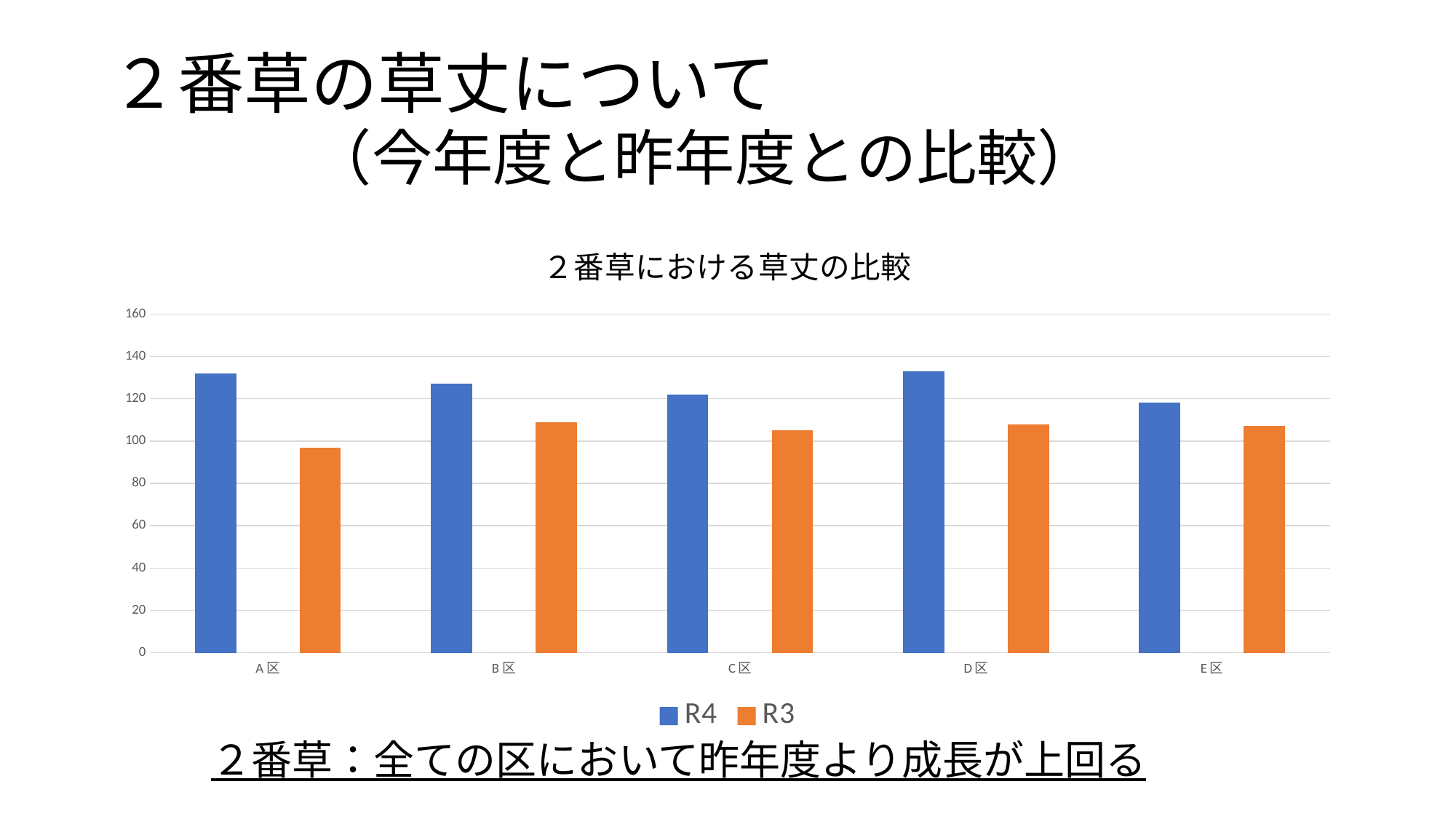
Which is larger, the R4 value for A区 or the R4 value for E区? A区 How many categories (districts) are shown on the x axis? 5 How many series does the legend list? 2 What kind of chart is shown on the slide? bar chart Which district has the lowest R3 value? A区 In A区, which is larger, the R4 value or the R3 value? R4 What is the title of the chart? ２番草における草丈の比較 Which series is shown in orange? R3 Is the R4 value for D区 greater or less than 120? greater Is the R3 value for C区 greater or less than 100? greater Is the R4 value for A区 greater or less than 120? greater